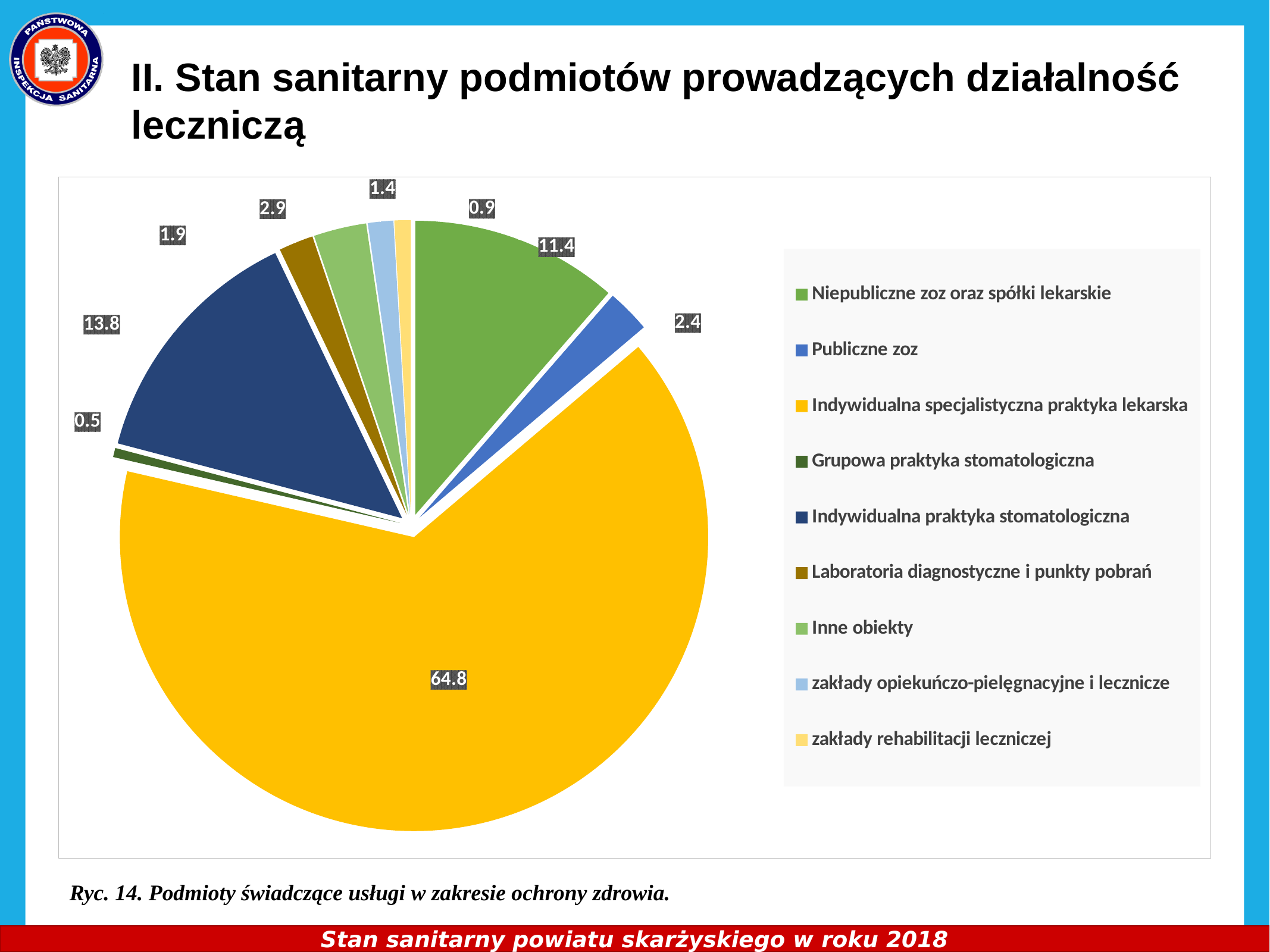
What kind of chart is shown on the slide? pie chart Which is larger: the value for Inne obiekty or the value for Laboratoria diagnostyczne i punkty pobrań? Inne obiekty What is the caption given below the chart? Ryc. 14. Podmioty świadczące usługi w zakresie ochrony zdrowia. What is the value shown for Indywidualna praktyka stomatologiczna? 13.8 What is the difference between the values for Indywidualna praktyka stomatologiczna and Niepubliczne zoz oraz spółki lekarskie? 2.4 Which category has the largest slice of the pie? Indywidualna specjalistyczna praktyka lekarska Which category has the smallest slice of the pie? Grupowa praktyka stomatologiczna What is the value shown for Grupowa praktyka stomatologiczna? 0.5 How many categories does the legend of the pie chart list? 9 What is the value shown for Indywidualna specjalistyczna praktyka lekarska? 64.8 What is the value shown for Publiczne zoz? 2.4 What is the value shown for Niepubliczne zoz oraz spółki lekarskie? 11.4